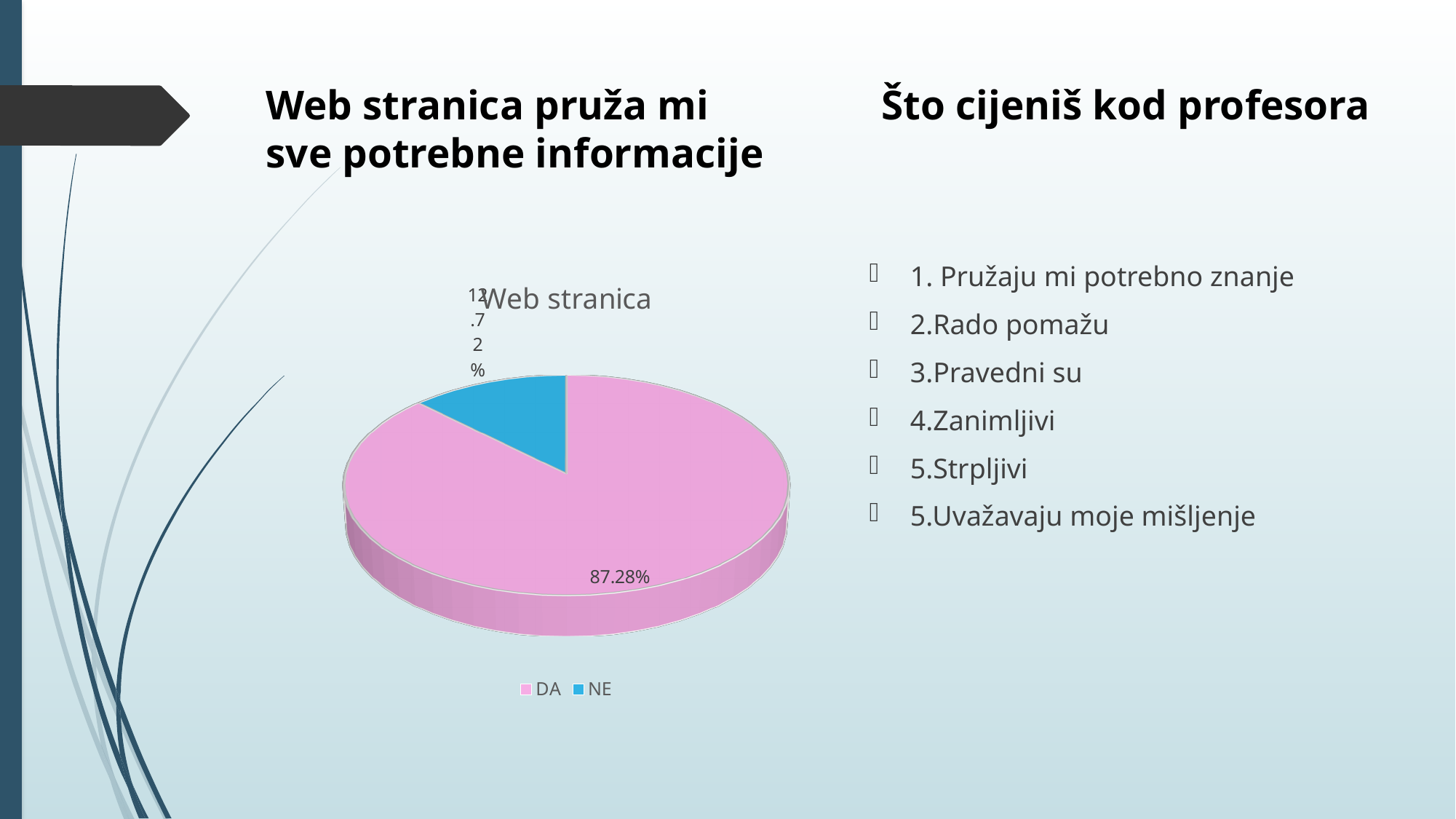
What share of the pie does the DA slice represent? 87.28% Which category has the largest slice of the pie? DA What percentage of the pie is labelled NE? 12.72% What percentage of the pie is labelled DA? 87.28% What kind of chart is shown on the slide? pie chart What is the title of the chart? Web stranica How many slices does the pie chart have? 2 What colour is the DA slice in the pie chart? pink What is the difference in percentage points between the DA slice and the NE slice? 74.56 Which is larger, the DA slice or the NE slice? DA Which category has the smallest slice of the pie? NE How many entries does the chart legend list? 2